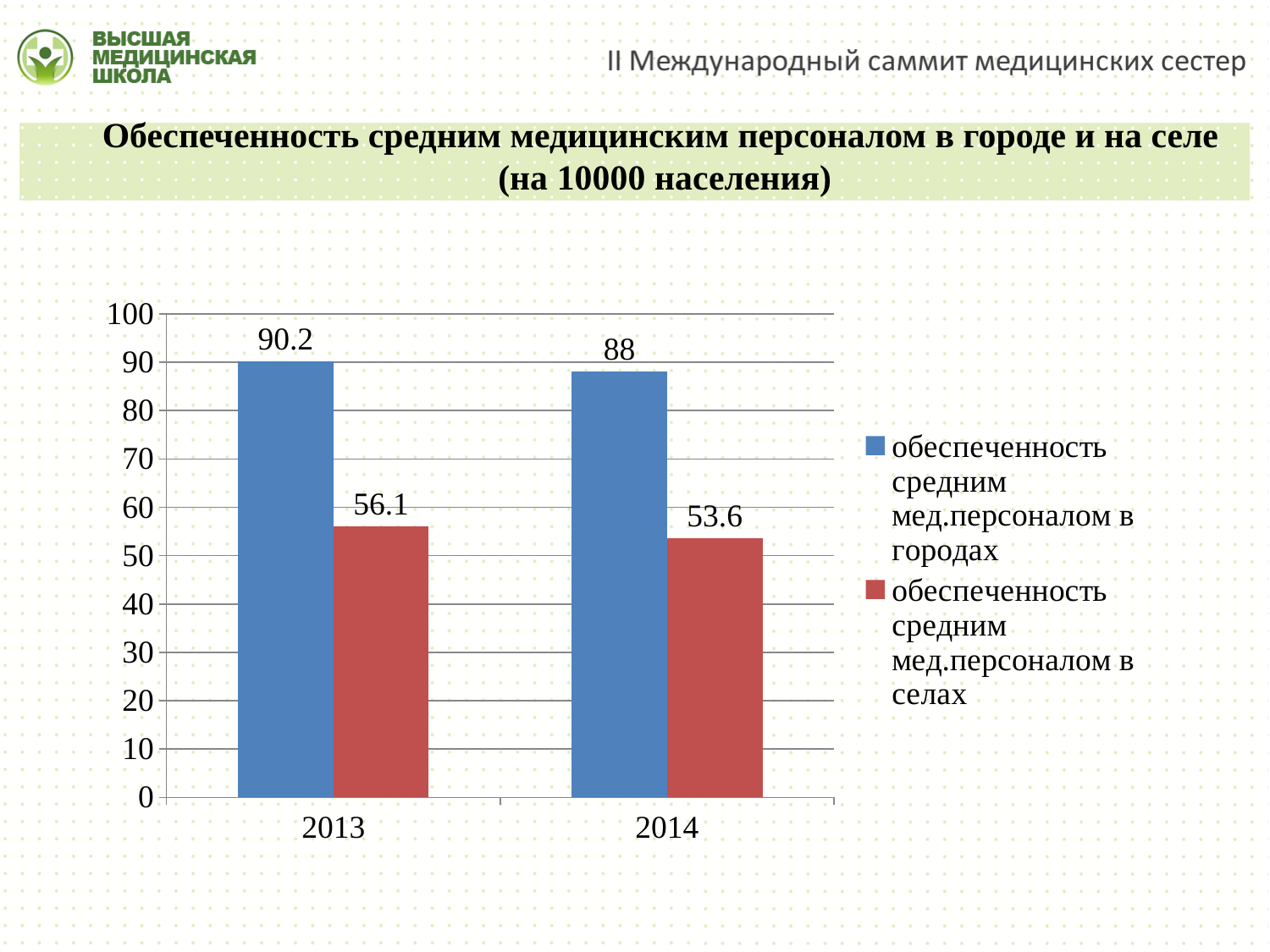
What is the value for rural areas (обеспеченность средним мед.персоналом в селах) in 2014? 53.6 What is the difference between the urban and rural values in 2013? 34.1 How many series does the legend list? 2 How many years are shown on the x axis? 2 Which year has the lower value for rural areas (в селах)? 2014 Which year has the higher value for urban areas (в городах)? 2013 What kind of chart is shown on the slide? bar chart What is the value for urban areas (в городах) in 2014? 88 What is the value for rural areas (в селах) in 2013? 56.1 By how much did the urban value (в городах) decrease from 2013 to 2014? 2.2 Is the rural value (в селах) in 2014 greater or less than the urban value (в городах) in 2014? less What is the value for urban areas (обеспеченность средним мед.персоналом в городах) in 2013? 90.2